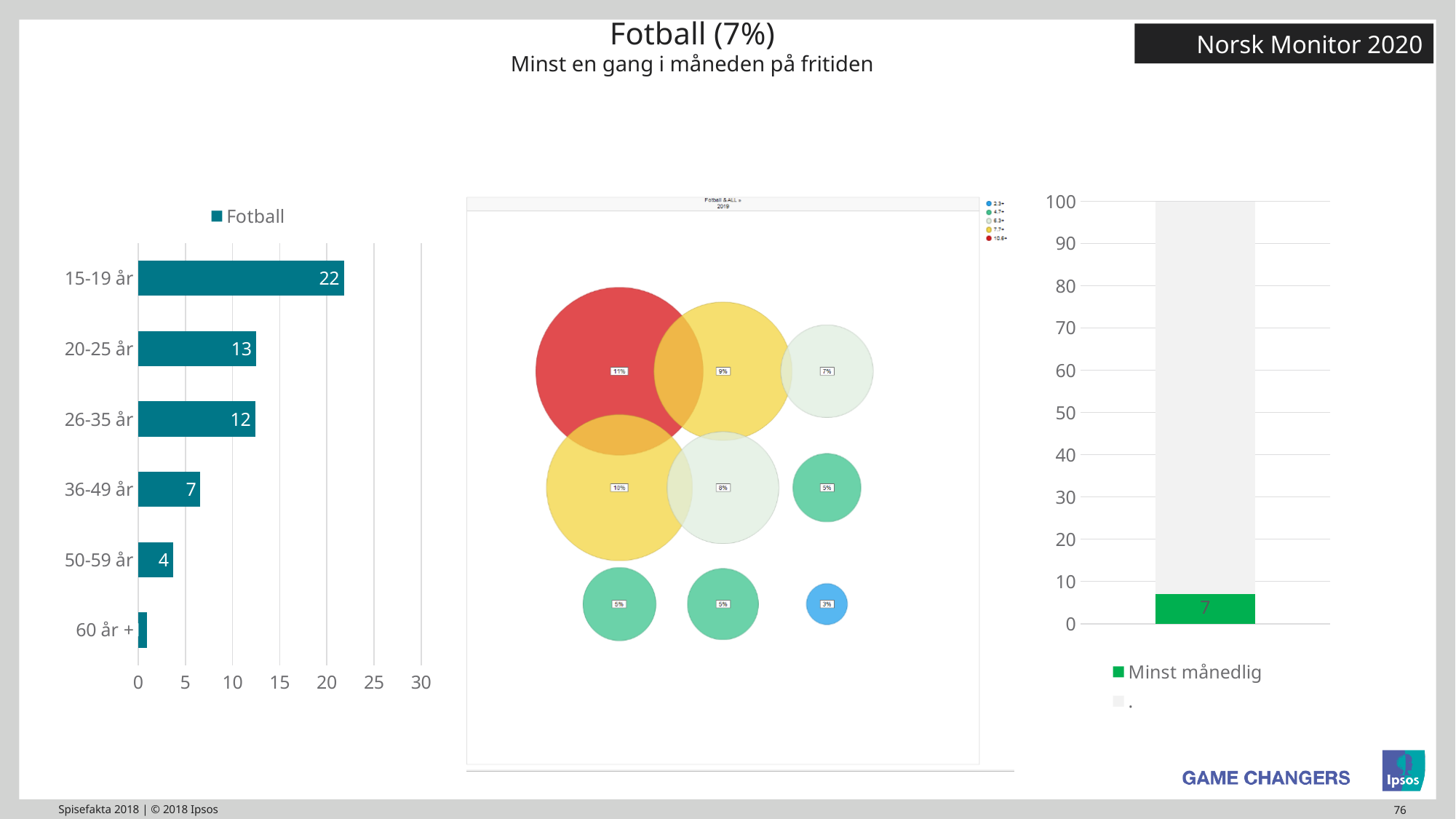
What kind of chart is the chart on the left of the slide? bar chart In the left bar chart, which is larger: the value for 26-35 år or the value for 36-49 år? 26-35 år How many age groups are shown in the left bar chart? 6 In the left bar chart, what is the value for the 36-49 år age group? 7 In the left bar chart, which age group has the highest value? 15-19 år In the left bar chart, is the value for 60 år + greater or less than 5? less In the left bar chart, what is the difference between the values for 15-19 år and 20-25 år? 9 In the left bar chart, which age group has the lowest value? 60 år + In the left bar chart, what is the value for the 15-19 år age group? 22 What is the legend entry shown above the left bar chart? Fotball In the right-hand chart, what is the value for Minst månedlig? 7 In the left bar chart, what is the value for the 50-59 år age group? 4